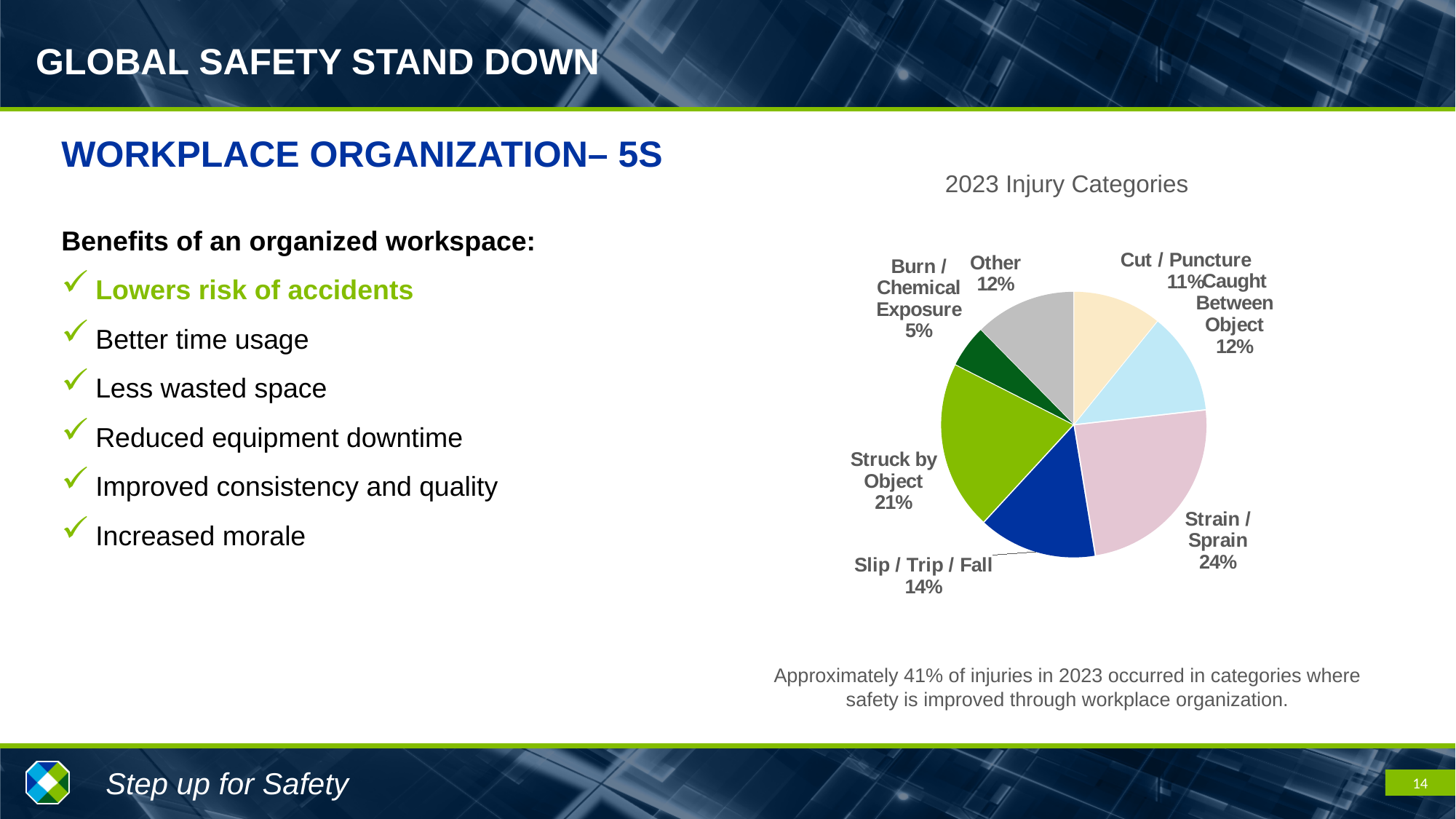
Which has a larger share, Struck by Object or Caught Between Object? Struck by Object How many injury categories are shown in the pie chart? 7 What share of injuries is attributed to Slip / Trip / Fall? 14% What share of injuries is attributed to Struck by Object? 21% Which injury category has the smallest share of the pie? Burn / Chemical Exposure What type of chart is shown on the slide? Pie chart What share of injuries is attributed to Burn / Chemical Exposure? 5% Which injury category has the largest share of the pie? Strain / Sprain What is the difference in percentage points between Strain / Sprain and Slip / Trip / Fall? 10 What share of injuries is attributed to Cut / Puncture? 11% What is the title of the chart? 2023 Injury Categories What share of injuries is attributed to Strain / Sprain? 24%